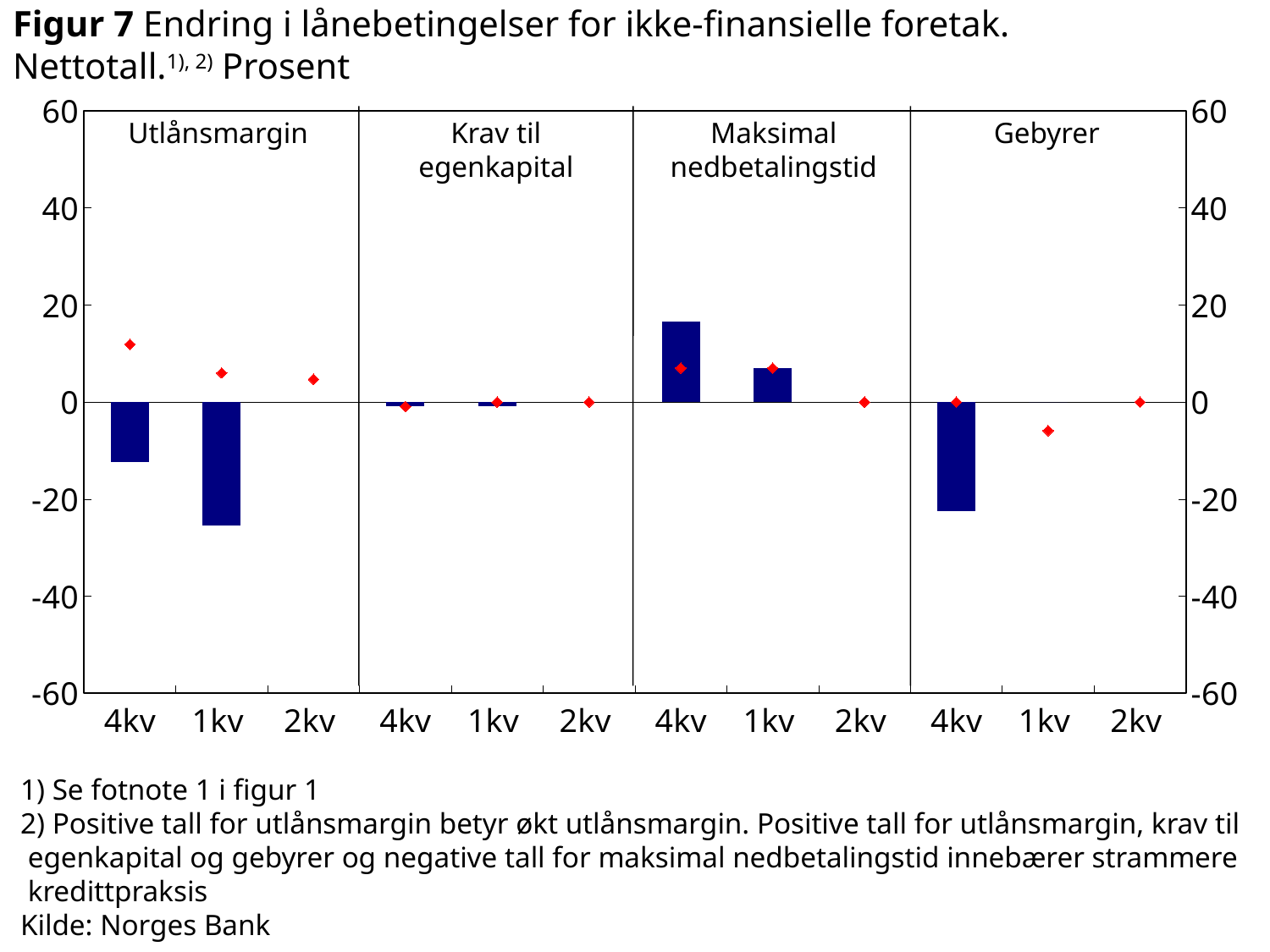
In the Utlånsmargin panel, is the bar for 4kv greater or less than -20? greater In the Utlånsmargin panel, which bar is lower, 4kv or 1kv? 1kv What kind of chart is shown on the slide? bar chart In the Utlånsmargin panel, is the bar for 1kv greater or less than -20? less In the Maksimal nedbetalingstid panel, is the bar for 4kv greater or less than 20? less How many panels (loan condition categories) does the chart have? 4 Which panel contains the highest positive bar in the chart? Maksimal nedbetalingstid In the Maksimal nedbetalingstid panel, which bar is larger, 4kv or 1kv? 4kv How many quarters are shown on the x axis within each panel? 3 What source is cited for the chart? Norges Bank